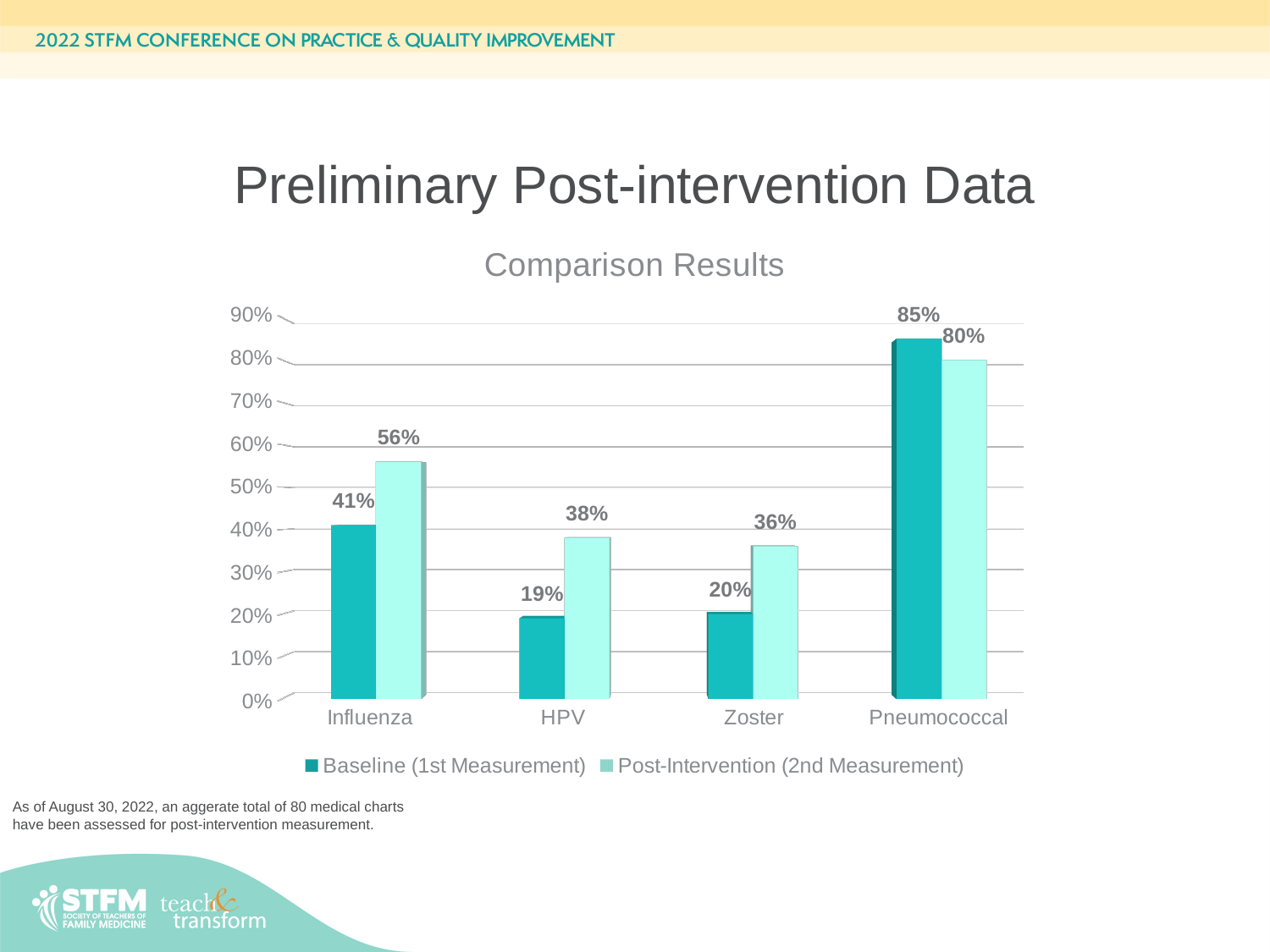
What kind of chart is shown on the slide? Bar chart What is the Post-Intervention (2nd Measurement) value for Pneumococcal? 80% What is the Post-Intervention (2nd Measurement) value for HPV? 38% What is the title of the chart? Comparison Results Which is larger for Pneumococcal: the Baseline (1st Measurement) or the Post-Intervention (2nd Measurement) value? Baseline (1st Measurement) Which category has the lowest Baseline (1st Measurement) value? HPV Which category has the highest Baseline (1st Measurement) value? Pneumococcal What is the Baseline (1st Measurement) value for Zoster? 20% What is the difference between the Post-Intervention and Baseline values for Influenza? 15% What is the Baseline (1st Measurement) value for Influenza? 41% How many series does the legend list? 2 How many categories are shown on the x axis? 4